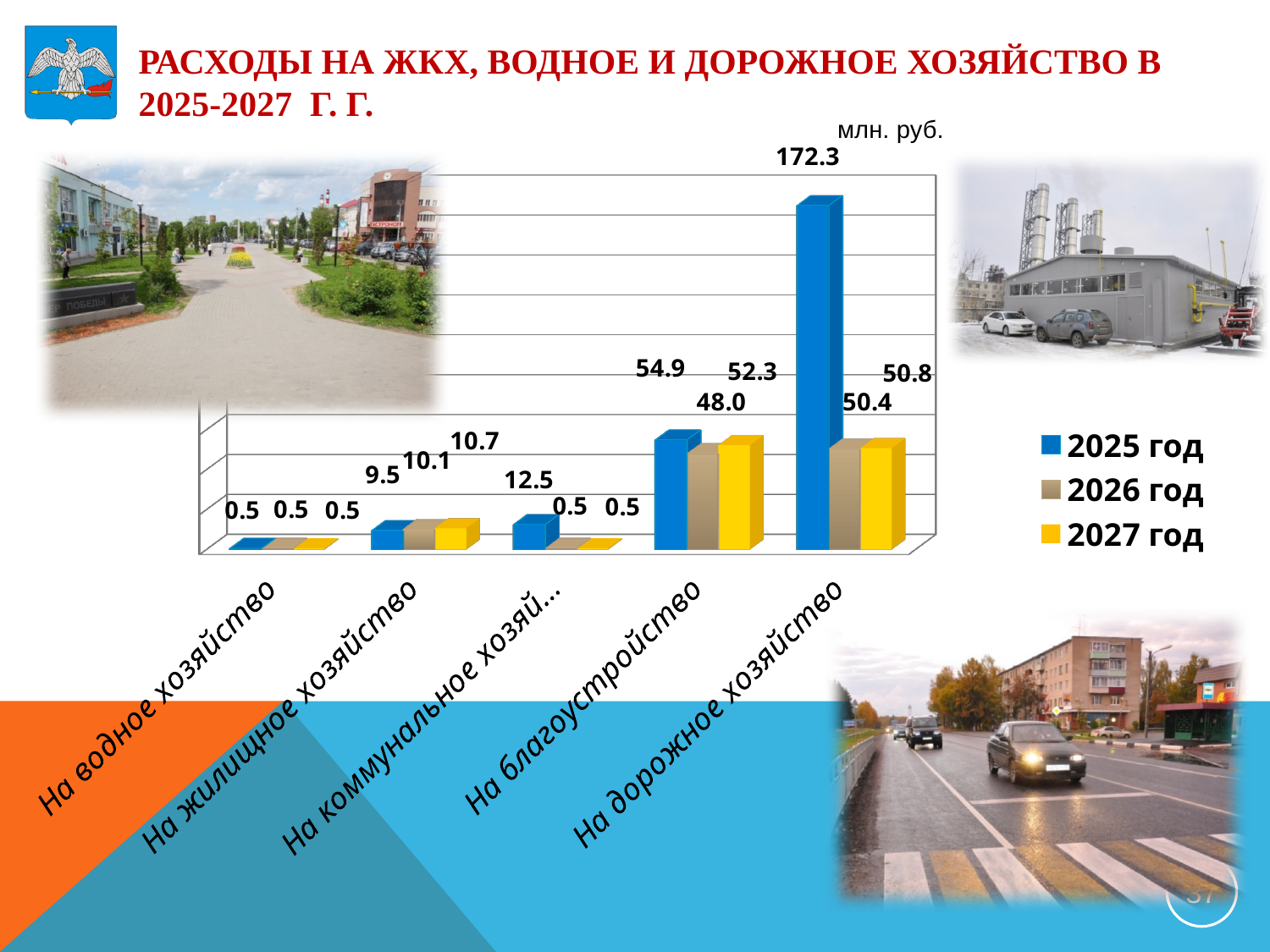
What is the value for На дорожное хозяйство in 2025 год? 172.3 How many series does the legend list? 3 What kind of chart is shown on the slide? Bar chart How many categories are shown on the x axis of the chart? 5 Which is larger for 2027 год: На благоустройство or На дорожное хозяйство? На благоустройство What is the value for На водное хозяйство in 2025 год? 0.5 Which category has the highest value for 2025 год? На дорожное хозяйство What is the difference between the 2025 год and 2026 год values for На дорожное хозяйство? 121.9 Which year has the highest value for На благоустройство? 2025 год What is the difference between the 2025 год and 2026 год values for На благоустройство? 6.9 What is the value for На благоустройство in 2026 год? 48.0 What is the value for На жилищное хозяйство in 2027 год? 10.7